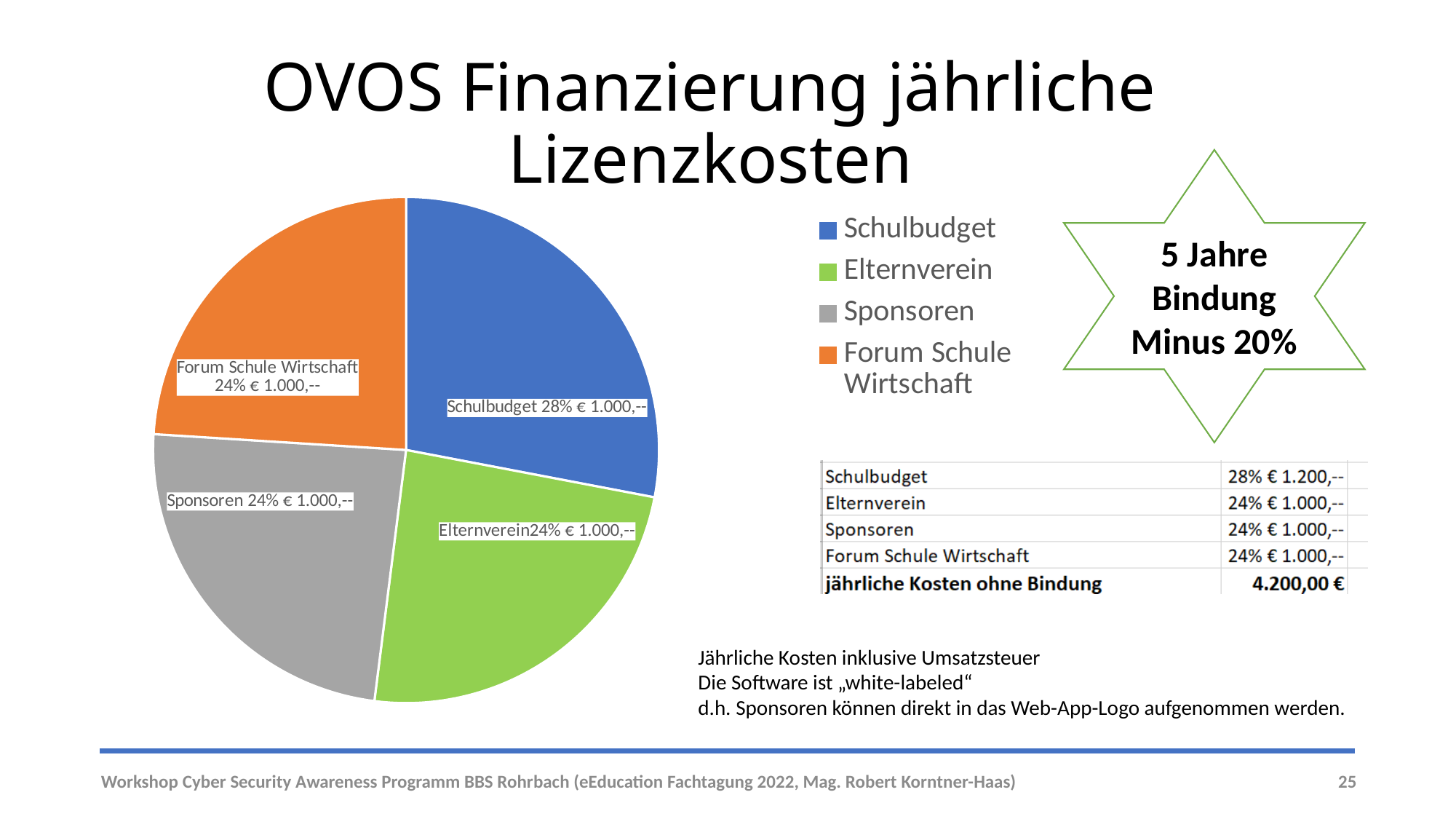
How many slices does the pie chart have? 4 What percentage share does the Schulbudget slice have in the pie chart? 28% What percentage share does the Sponsoren slice have in the pie chart? 24% What kind of chart is shown on the slide? pie chart What is the difference in percentage points between the Schulbudget share and the Sponsoren share in the pie chart? 4 What euro amount is printed on the Sponsoren slice of the pie chart? € 1.000,-- What euro amount is printed on the Elternverein slice of the pie chart? € 1.000,-- How many entries does the legend of the pie chart list? 4 Which slice of the pie chart has the largest share? Schulbudget What percentage share does the Forum Schule Wirtschaft slice have in the pie chart? 24% Which colour represents Forum Schule Wirtschaft in the pie chart? orange